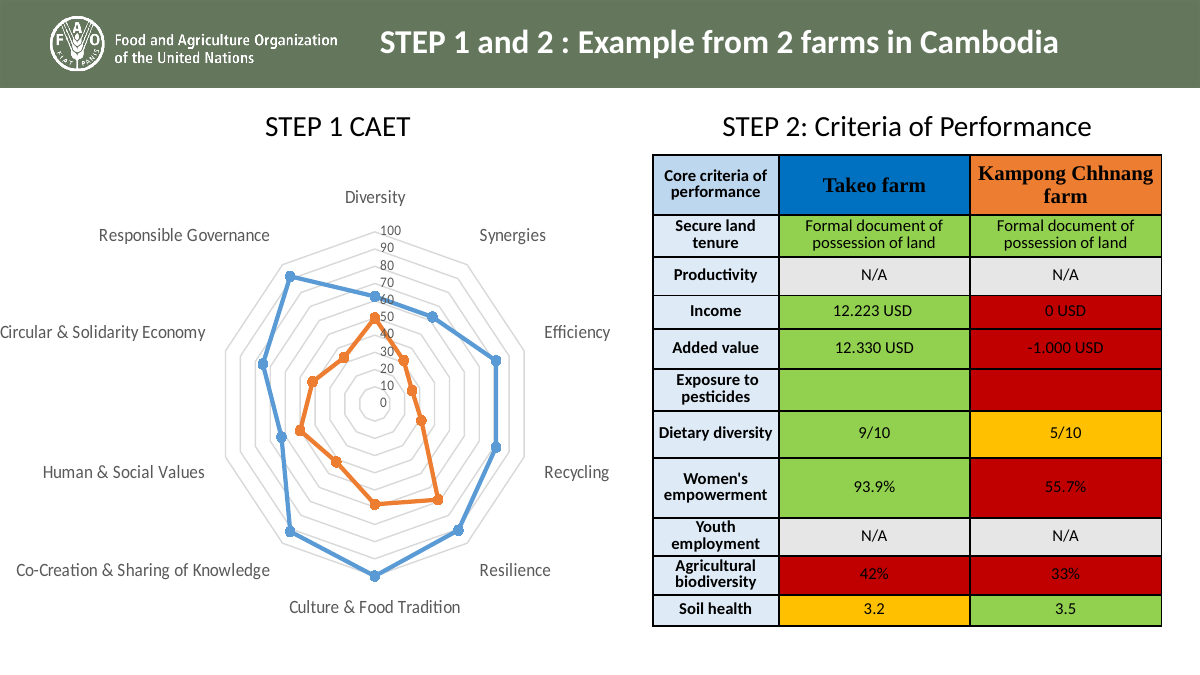
What kind of chart is shown under STEP 1 CAET? radar chart On the STEP 1 CAET chart, which category has the highest value for the blue series? Culture & Food Tradition What is the title of the chart on the left of the slide? STEP 1 CAET On the STEP 1 CAET chart, which series has the larger value for Culture & Food Tradition, the blue or the orange one? blue How many data series are plotted on the STEP 1 CAET radar chart? 2 On the STEP 1 CAET chart, is the orange series value for Culture & Food Tradition greater or less than 80? less On the STEP 1 CAET chart, is the orange series value for Efficiency greater or less than 60? less On the STEP 1 CAET chart, is the blue series value for Culture & Food Tradition greater or less than 80? greater What is the maximum value shown on the radial axis of the STEP 1 CAET chart? 100 How many categories (axes) does the STEP 1 CAET radar chart have? 10